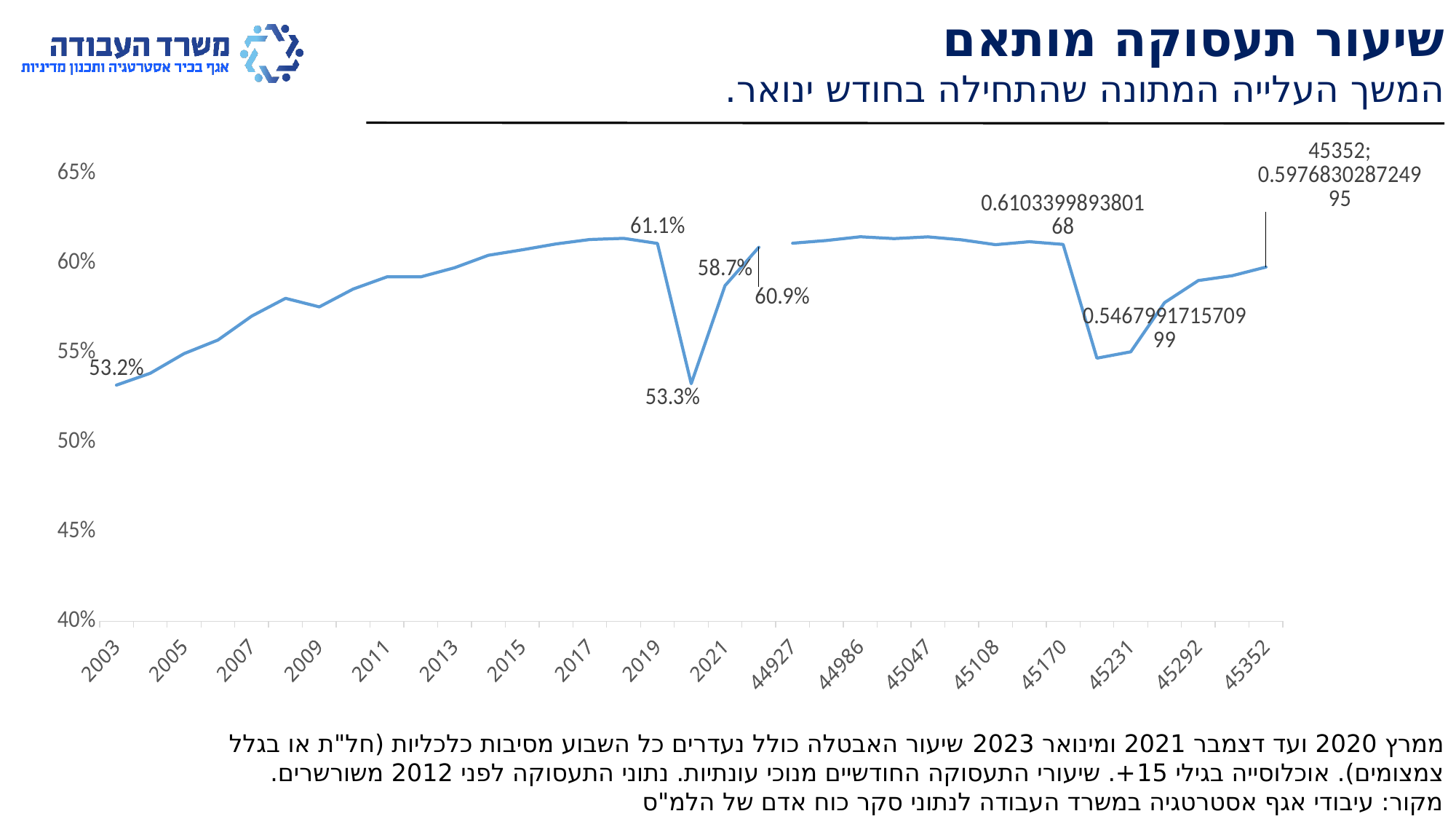
What kind of chart is shown on the slide? line chart What is the lowest value shown on the vertical axis? 40% Does the line rise or fall between 2003 and 2017? rises What is the value labelled at the start of the line, for 2003? 53.2% Which is larger, the value labelled 58.7% or the value labelled 60.9%? 60.9% What data label is shown for the last point, 45352? 45352; 0.597683028724995 What value is labelled at the sharp dip around 2020? 53.3% What is the highest value labelled with a percent sign on the chart? 61.1% Is the value for 2011 greater or less than 55%? greater What is the difference between the labels 60.9% and 58.7%? 2.2 percentage points What is the difference between the 61.1% peak and the 53.3% dip? 7.8 percentage points Is the value for 2015 greater or less than 65%? less